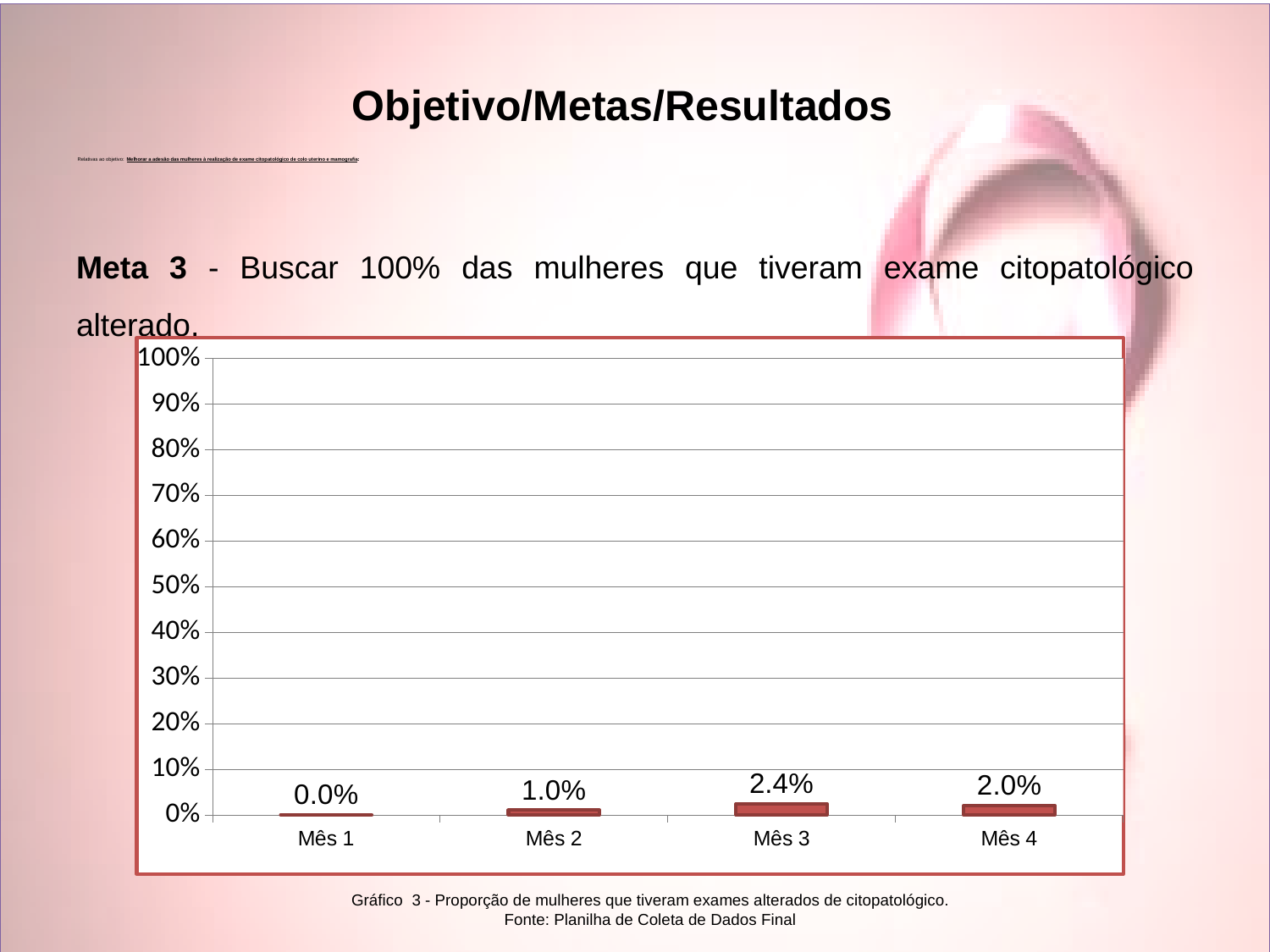
What is the difference between the values for Mês 3 and Mês 2? 1.4% Which month has the highest value? Mês 3 Which is larger, the value for Mês 2 or the value for Mês 4? Mês 4 How many months are shown on the x axis? 4 What is the value for Mês 4? 2.0% What is the highest value shown on the y axis? 100% What is the value for Mês 1? 0.0% What is the value for Mês 3? 2.4% What is the caption given below the chart? Gráfico 3 - Proporção de mulheres que tiveram exames alterados de citopatológico. Which month has the lowest value? Mês 1 Is the value for Mês 3 greater or less than 10%? less What kind of chart is shown on the slide? bar chart